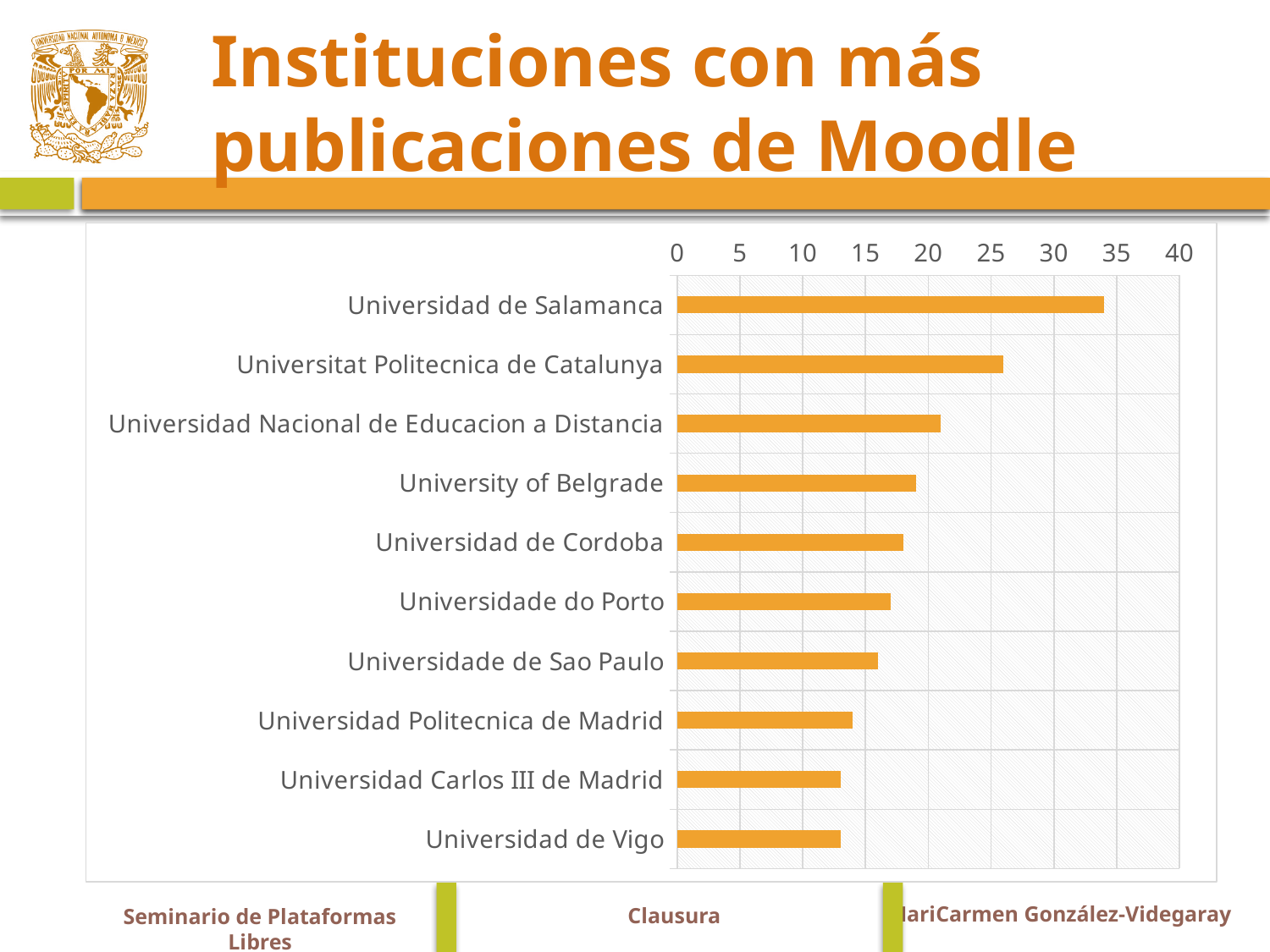
Which has a larger value, Universidad de Salamanca or Universitat Politecnica de Catalunya? Universidad de Salamanca What is the title of the slide containing the chart? Instituciones con más publicaciones de Moodle Is the value for Universitat Politecnica de Catalunya greater or less than 25? greater Which has a larger value, Universidad Nacional de Educacion a Distancia or Universidade de Sao Paulo? Universidad Nacional de Educacion a Distancia How many institutions are listed in the chart? 10 Is the value for Universidad Politecnica de Madrid greater or less than 15? less Is the value for Universidad de Vigo greater or less than 15? less What kind of chart is shown on the slide? bar chart Which institution has the highest number of publications in the chart? Universidad de Salamanca